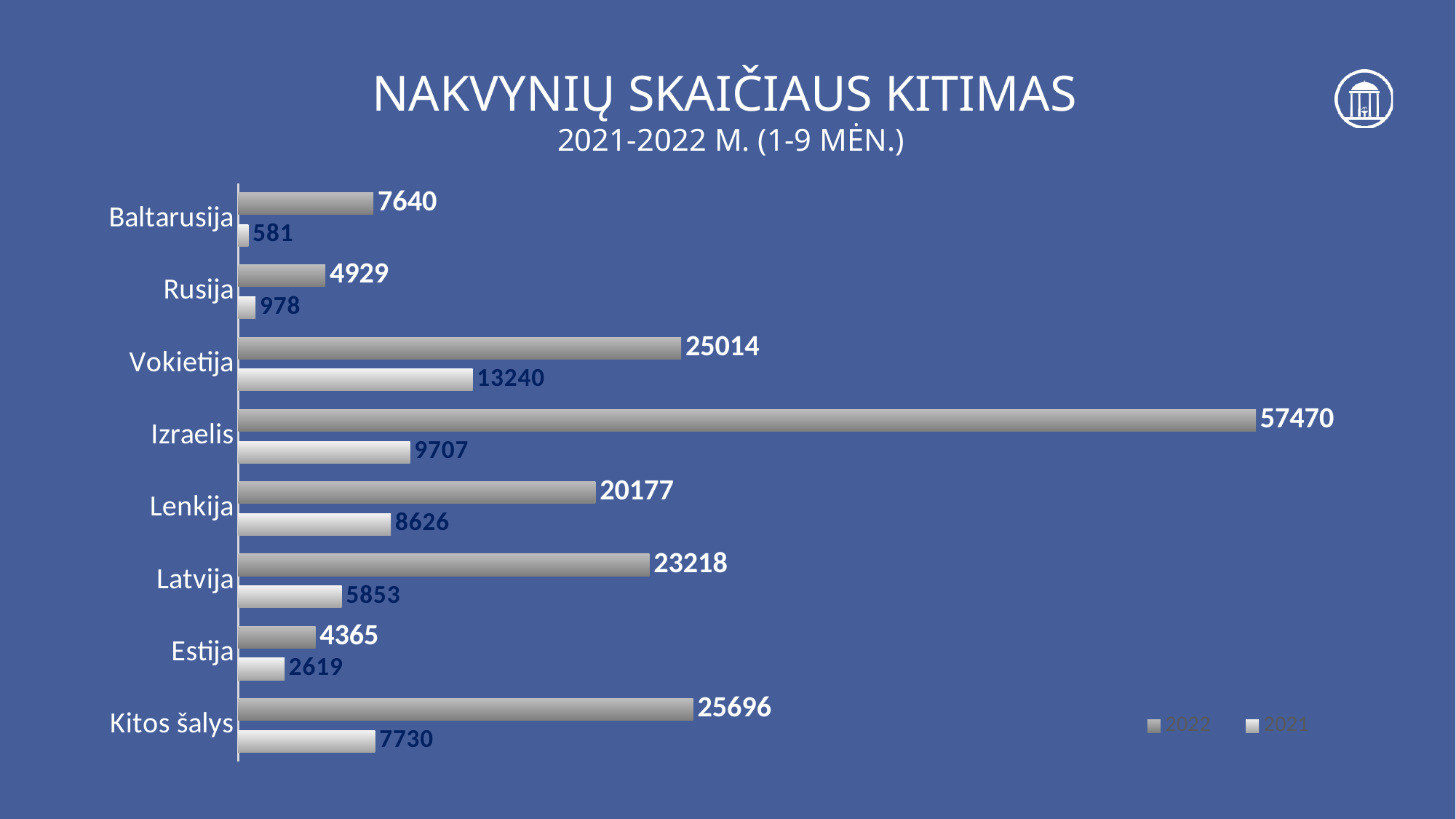
What is the 2022 value for Izraelis? 57470 Which category has the highest 2022 value? Izraelis What is the difference between the 2022 and 2021 values for Lenkija? 11551 What kind of chart is shown on the slide? Bar chart What are the two series listed in the legend? 2022 and 2021 What is the 2022 value for Latvija? 23218 How many categories are shown on the chart? 8 Which is larger, the 2022 value for Vokietija or the 2022 value for Kitos šalys? Kitos šalys What is the 2021 value for Baltarusija? 581 Which category has the lowest 2021 value? Baltarusija What is the 2021 value for Vokietija? 13240 How many series does the legend list? 2